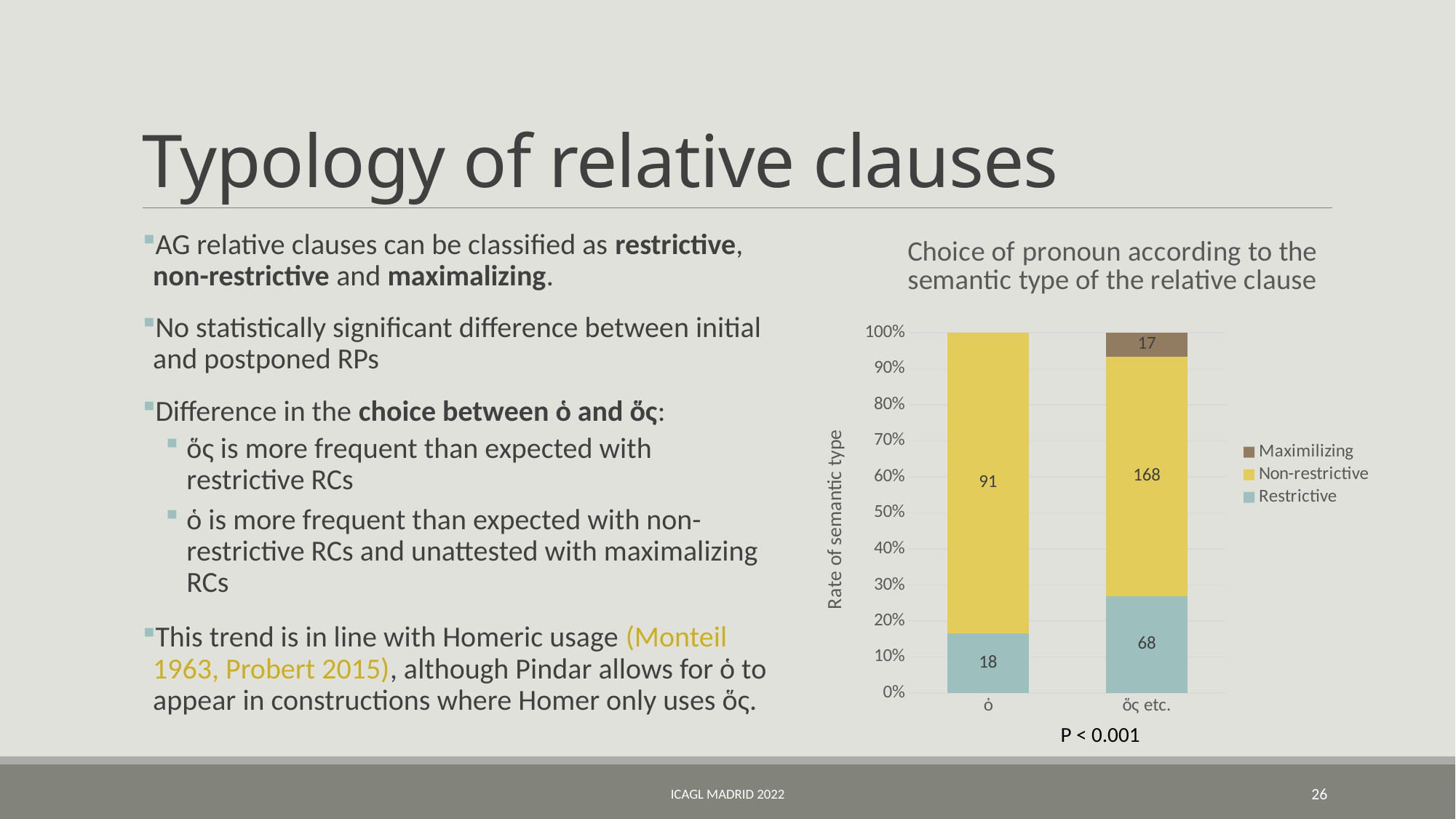
Is the Restrictive share of the ὅς etc. bar greater or less than 20%? greater What is the title of the chart? Choice of pronoun according to the semantic type of the relative clause Which category has the larger Non-restrictive value, ὁ or ὅς etc.? ὅς etc. What is the Non-restrictive value for ὅς etc.? 168 What is the Maximizing value for ὅς etc.? 17 How many categories are shown on the x axis of the chart? 2 What is the Restrictive value for ὁ? 18 What kind of chart is shown on the slide? stacked bar chart What is the Non-restrictive value for ὁ? 91 What is the difference between the Restrictive values for ὅς etc. and ὁ? 50 What is the total of the labelled values in the ὅς etc. bar? 253 How many series does the chart legend list? 3